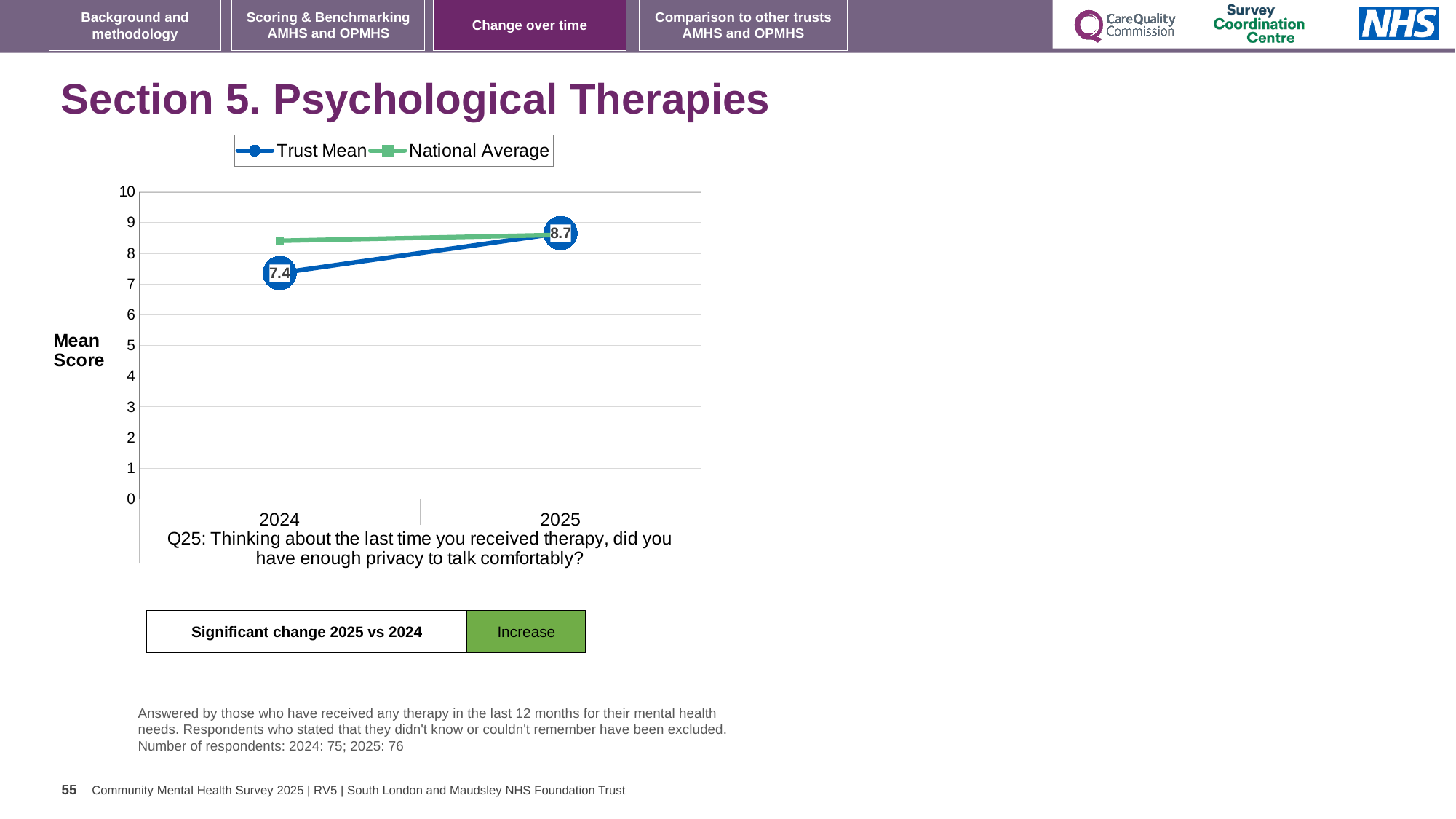
What is the Trust Mean score for 2024? 7.4 Does the Trust Mean rise or fall from 2024 to 2025? Rise What kind of chart is shown on the slide? Line chart In which year is the Trust Mean lowest? 2024 By how much did the Trust Mean change from 2024 to 2025? 1.3 In which year is the Trust Mean higher, 2024 or 2025? 2025 How many series does the legend list? 2 How many years are plotted on the x axis? 2 What is the Trust Mean score for 2025? 8.7 Is the National Average value for 2024 greater or less than 8? greater Is the National Average value for 2025 greater or less than 9? less In 2024, which is larger, the Trust Mean or the National Average? National Average